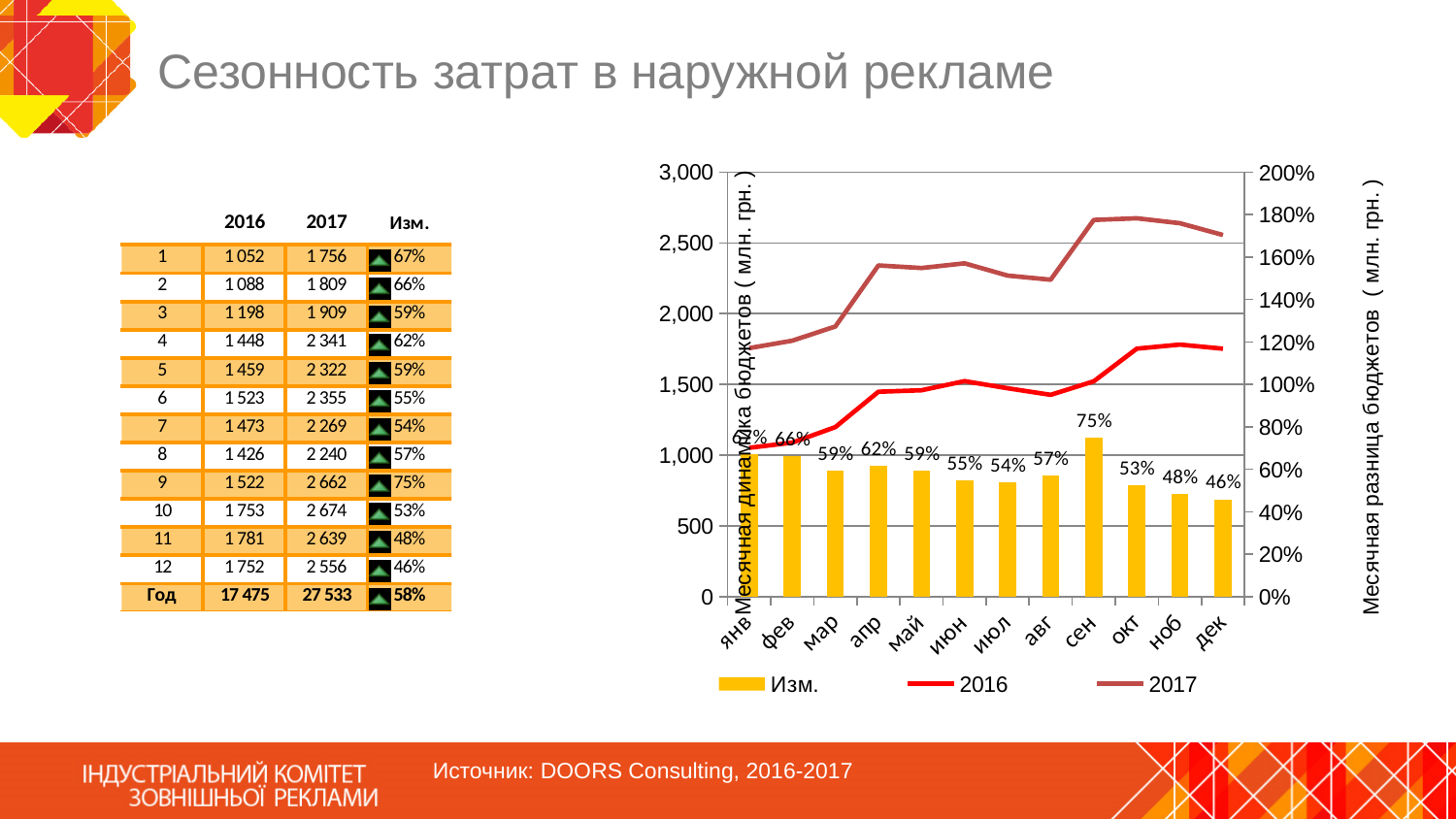
How many series does the chart legend list? 3 What is the Изм. value for апр (April) in the chart? 62% Is the 2016 line value for янв greater or less than 1,500? less Which is larger, the Изм. value for фев or for мар? фев What is the difference between the Изм. values for сен and окт? 22% What is the Изм. value for дек (December) in the chart? 46% Is the 2017 line value for сен greater or less than 2,500? greater What kind of chart is shown on the slide? Combined bar and line chart Which month has the highest Изм. bar in the chart? сен What is the Изм. value for сен (September) in the chart? 75% Which month has the lowest Изм. bar in the chart? дек How many months are shown along the x axis of the chart? 12